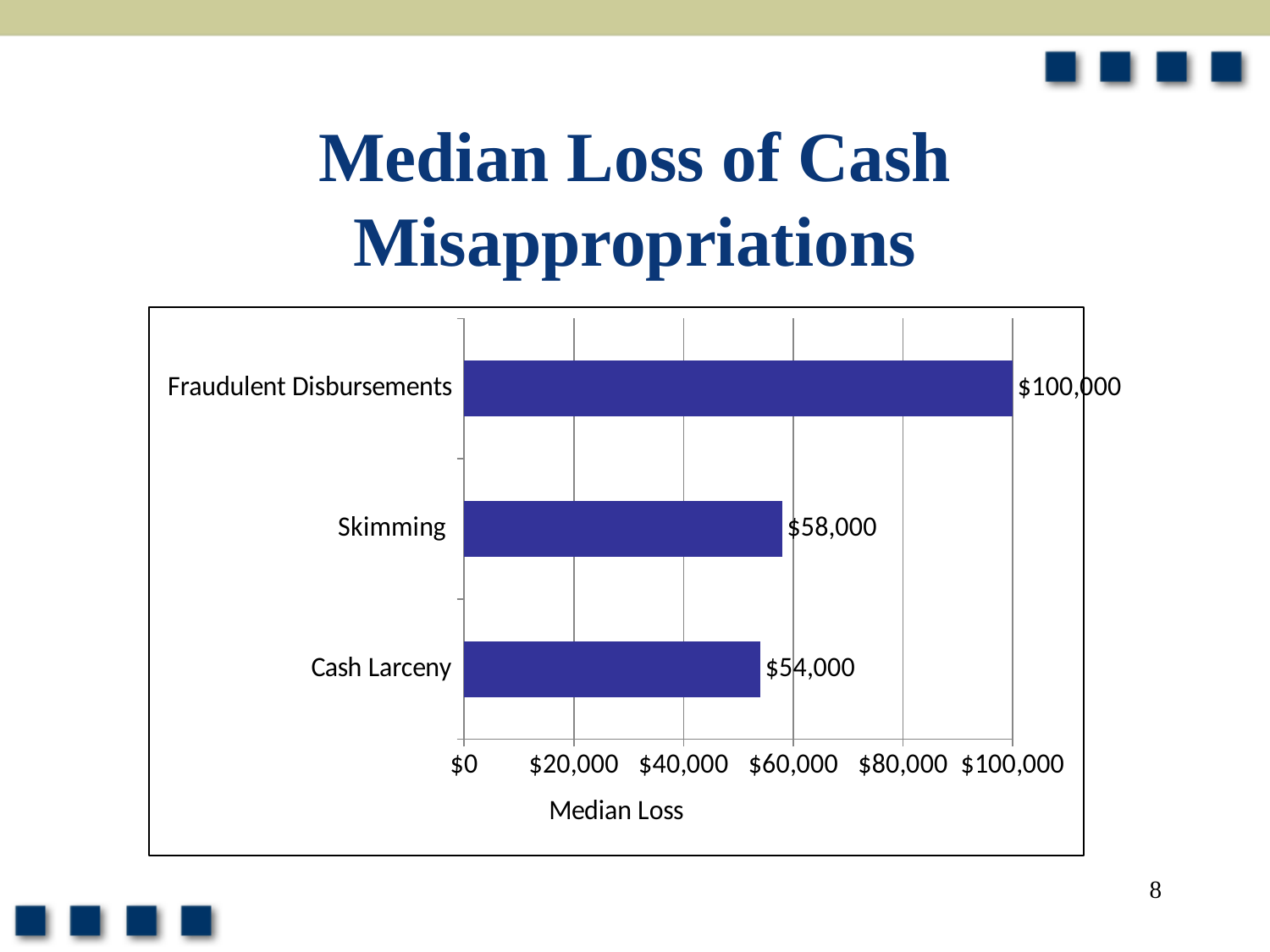
What is the label on the horizontal axis of the chart? Median Loss What is the median loss for Cash Larceny? $54,000 What is the median loss for Skimming? $58,000 Which category has the highest median loss? Fraudulent Disbursements What is the difference in median loss between Fraudulent Disbursements and Skimming? $42,000 What is the median loss for Fraudulent Disbursements? $100,000 What kind of chart is shown on the slide? bar chart Is the median loss for Cash Larceny greater or less than $60,000? less How many categories are shown in the chart? 3 What is the difference in median loss between Skimming and Cash Larceny? $4,000 Which has a larger median loss, Skimming or Cash Larceny? Skimming Which category has the lowest median loss? Cash Larceny